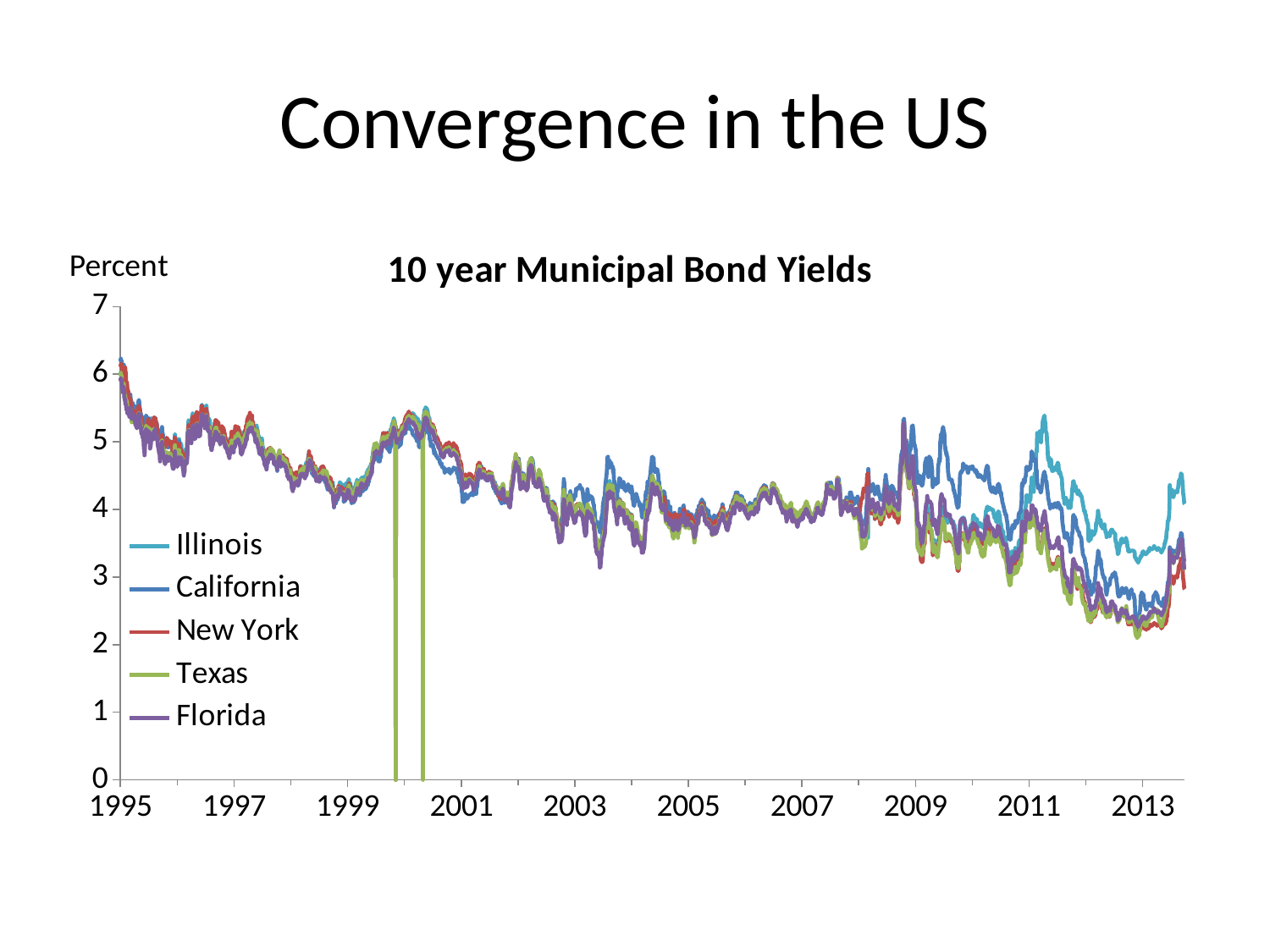
Overall, do the bond yields rise or fall from 1995 to 2013? fall In 2012, which is larger, the yield for Illinois or the yield for Texas? Illinois What is the highest value shown on the y axis? 7 Is the value for New York at the start of 1995 greater or less than 5? greater What unit is shown on the y axis of the chart? Percent How many series does the legend list? 5 What is the title of the chart? 10 year Municipal Bond Yields Is the value for Texas in early 2013 greater or less than 3? less Is the value for California in 2005 greater or less than 5? less Which series has the highest yield during 2012? Illinois What type of chart is shown on the slide? line chart